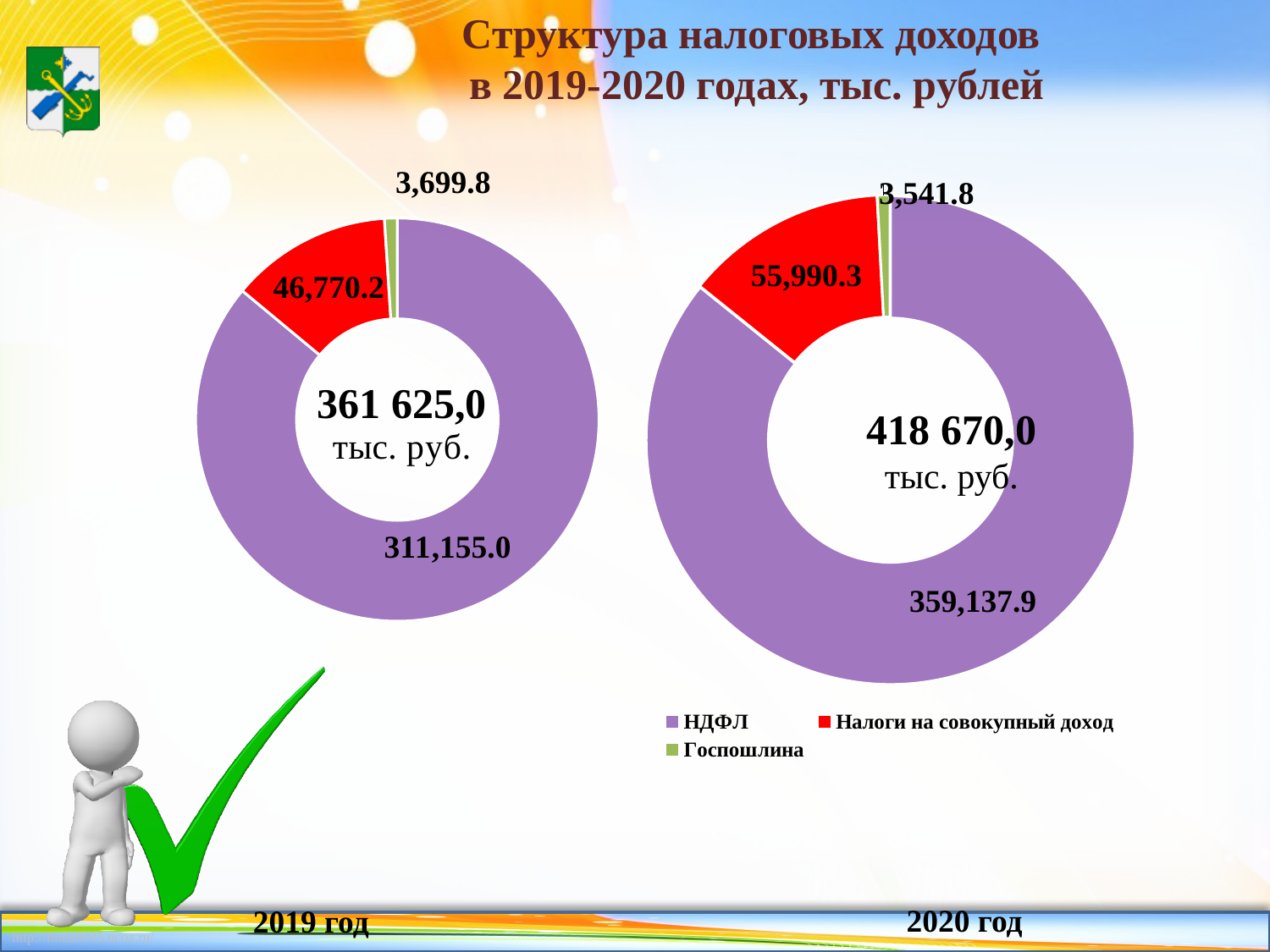
In the 2019 год chart, which category has the smallest value? Госпошлина In the 2019 год chart, what is the value for Госпошлина? 3,699.8 How many categories does each doughnut chart show? 3 In the 2019 год chart, what is the value for НДФЛ? 311,155.0 What type of chart is used for the 2019 год and 2020 год data? Doughnut chart What total is printed in the centre of the 2020 год chart? 418 670,0 тыс. руб. In the 2020 год chart, what is the value for Налоги на совокупный доход? 55,990.3 In the 2020 год chart, which category has the largest value? НДФЛ In the 2020 год chart, what is the value for Госпошлина? 3,541.8 What is the difference between Налоги на совокупный доход in the 2020 год chart and in the 2019 год chart? 9,220.1 Is the Госпошлина value larger in the 2019 год chart or the 2020 год chart? 2019 год What is the difference between the НДФЛ value in the 2020 год chart and the НДФЛ value in the 2019 год chart? 47,982.9